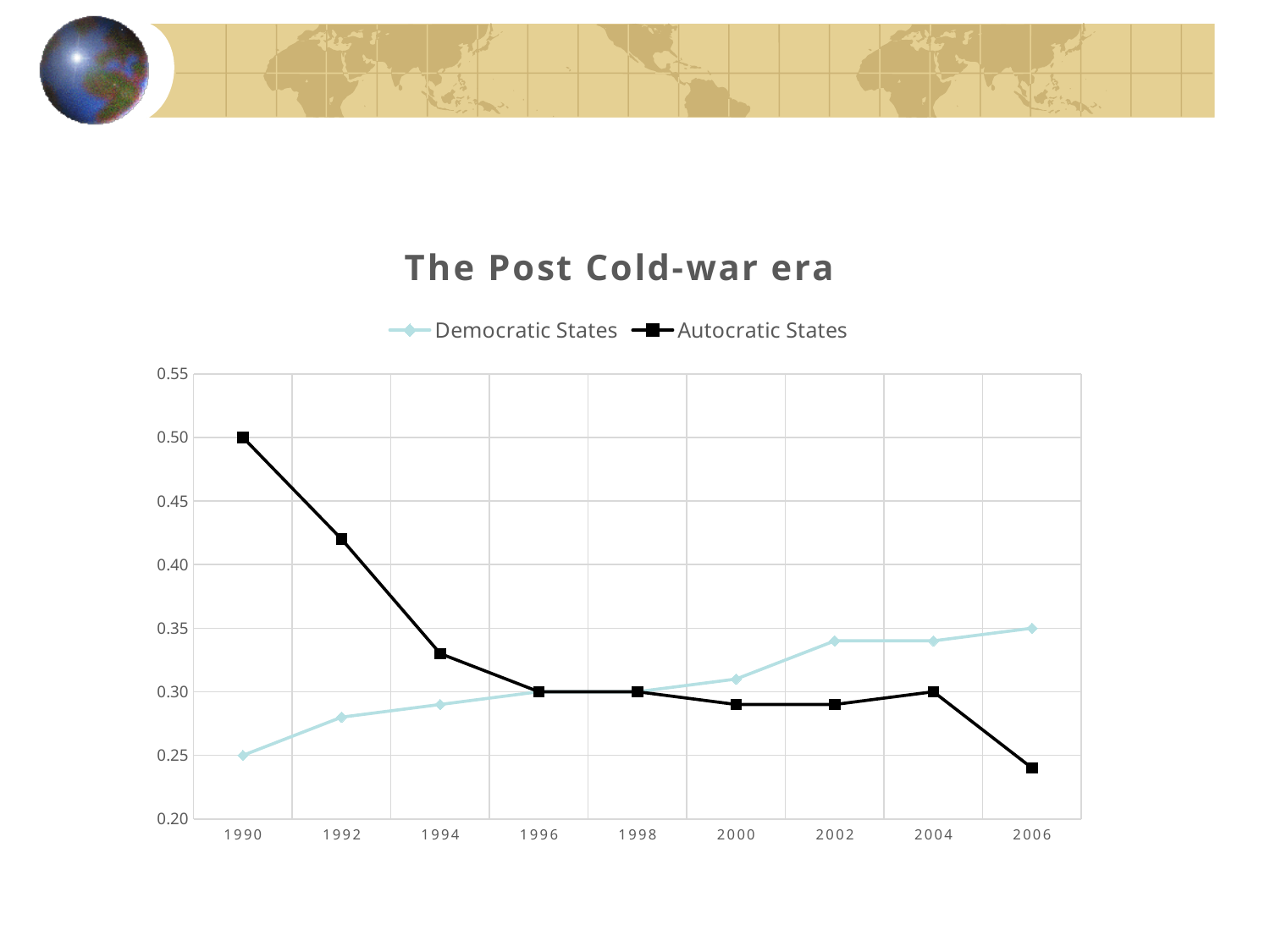
What is the value for Democratic States in 2006? 0.35 Does the Autocratic States line generally rise or fall from 1990 to 2006? fall Is the value for Autocratic States in 2006 greater or less than 0.25? less What is the value for Autocratic States in 1990? 0.50 How many years are plotted along the x axis? 9 What is the title of the chart? The Post Cold-war era Which series has the larger value in 1992, Democratic States or Autocratic States? Autocratic States In which year is the Autocratic States value highest? 1990 What type of chart is shown on the slide? line chart In which year is the Democratic States value lowest? 1990 How many series does the legend list? 2 What is the value for Autocratic States in 1996? 0.30